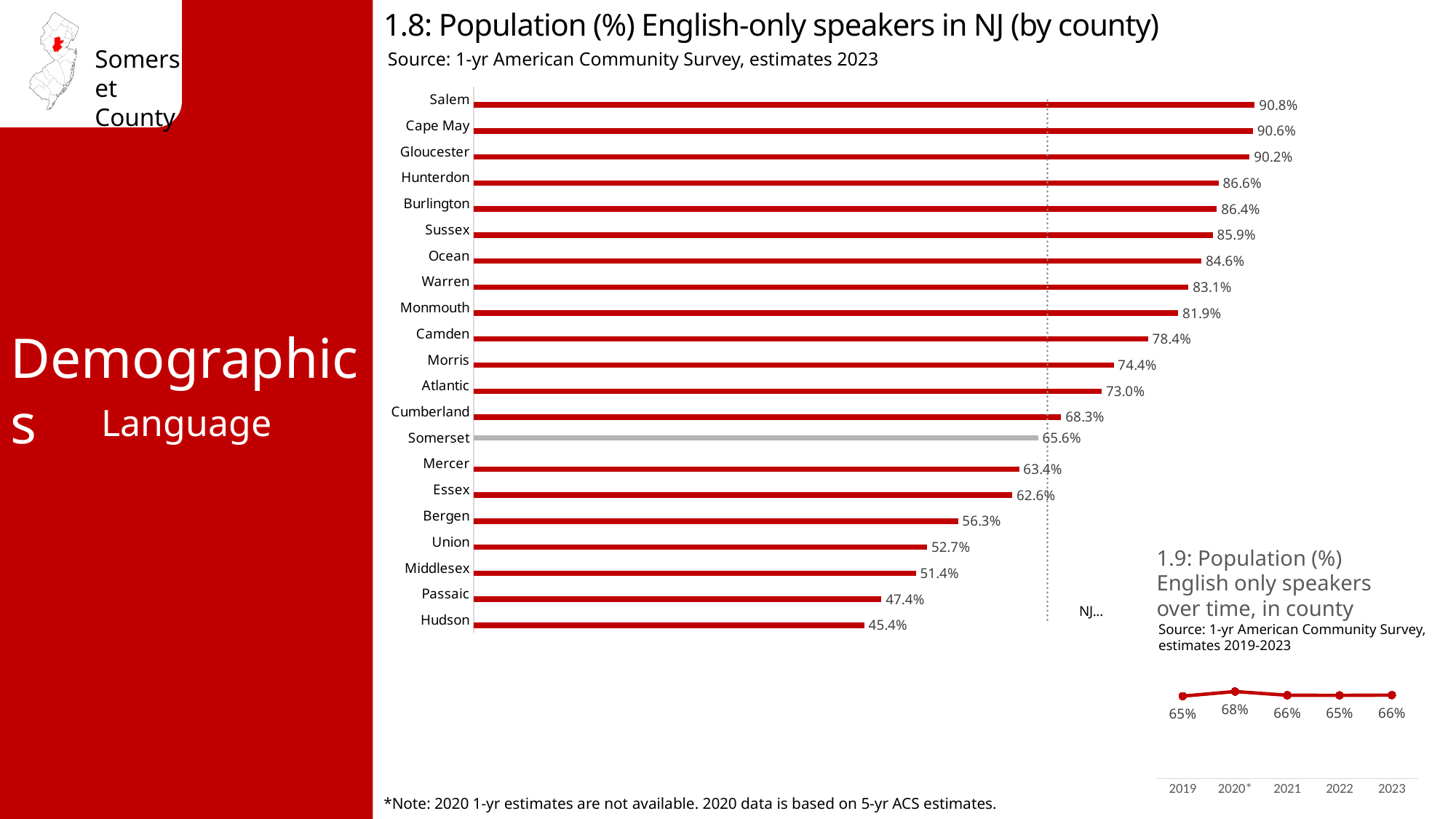
In chart 1.8, which has a higher value, Bergen or Mercer? Mercer In chart 1.8, which county has the lowest percentage of English-only speakers? Hudson In chart 1.8, which bar is shown in grey rather than red? Somerset In chart 1.8, what is the value for Hunterdon? 86.6% In chart 1.9, how many data points are plotted? 5 In chart 1.8, which county has the highest percentage of English-only speakers? Salem In chart 1.8, what is the value for Somerset? 65.6% In chart 1.9, what is the value for 2020*? 68% What kind of chart is chart 1.9? line chart In chart 1.8, what is the difference between the values for Salem and Hudson? 45.4% In chart 1.8, how many counties are shown? 21 What kind of chart is chart 1.8? bar chart